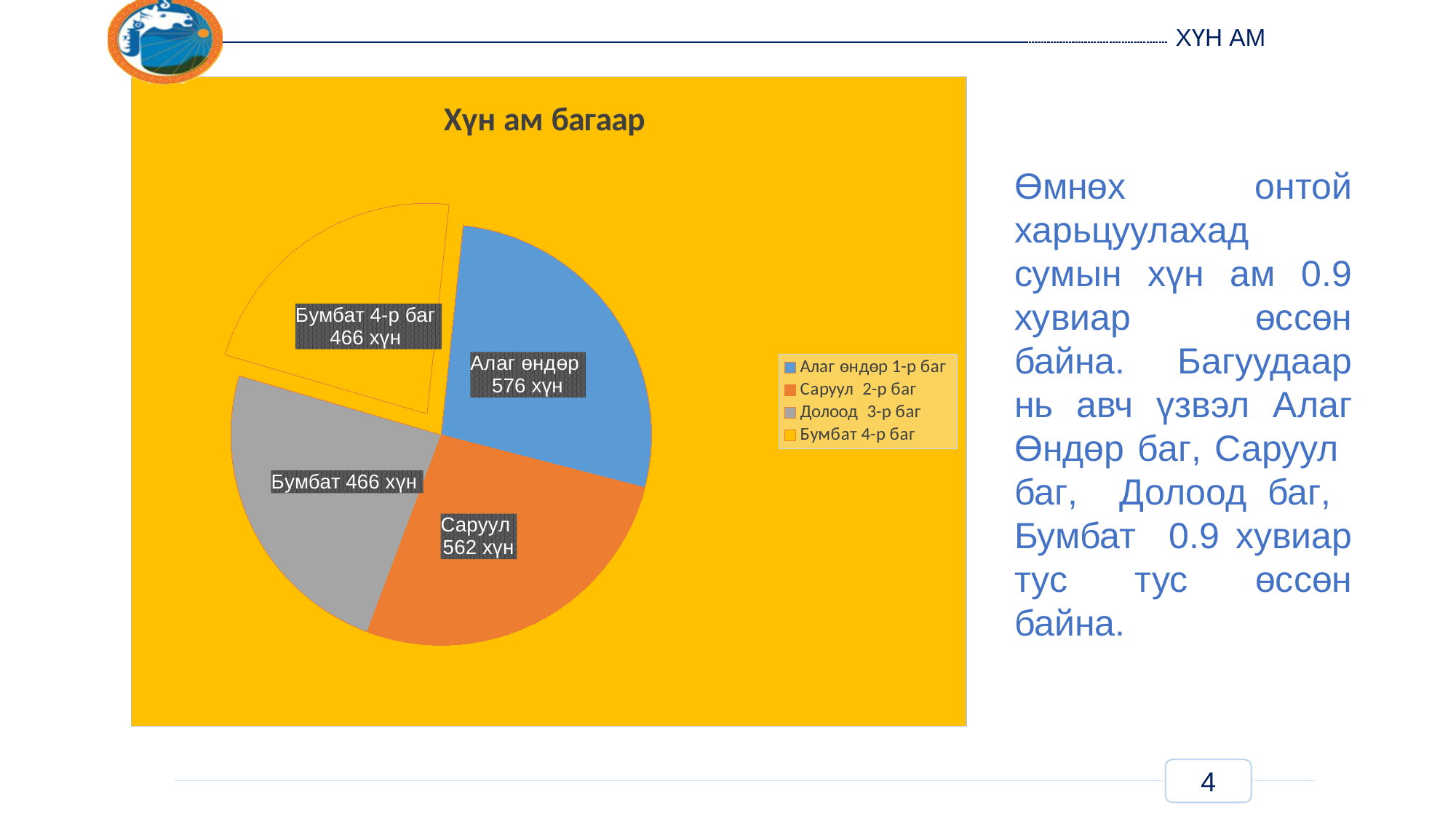
What colour is the Алаг өндөр 1-р баг slice? blue What is the title of the chart? Хүн ам багаар Which slice has the highest value according to the data labels? Алаг өндөр What value is shown for Саруул? 562 хүн What value is shown for Алаг өндөр? 576 хүн How many slices does the pie chart have? 4 What is the difference between the values for Алаг өндөр and Саруул? 14 Which slice is pulled out (exploded) from the rest of the pie? Бумбат 4-р баг What type of chart is shown on the slide? pie chart Which is larger, the value for Саруул or the value for Бумбат 4-р баг? Саруул What value is shown for Бумбат 4-р баг? 466 хүн How many entries does the chart legend list? 4